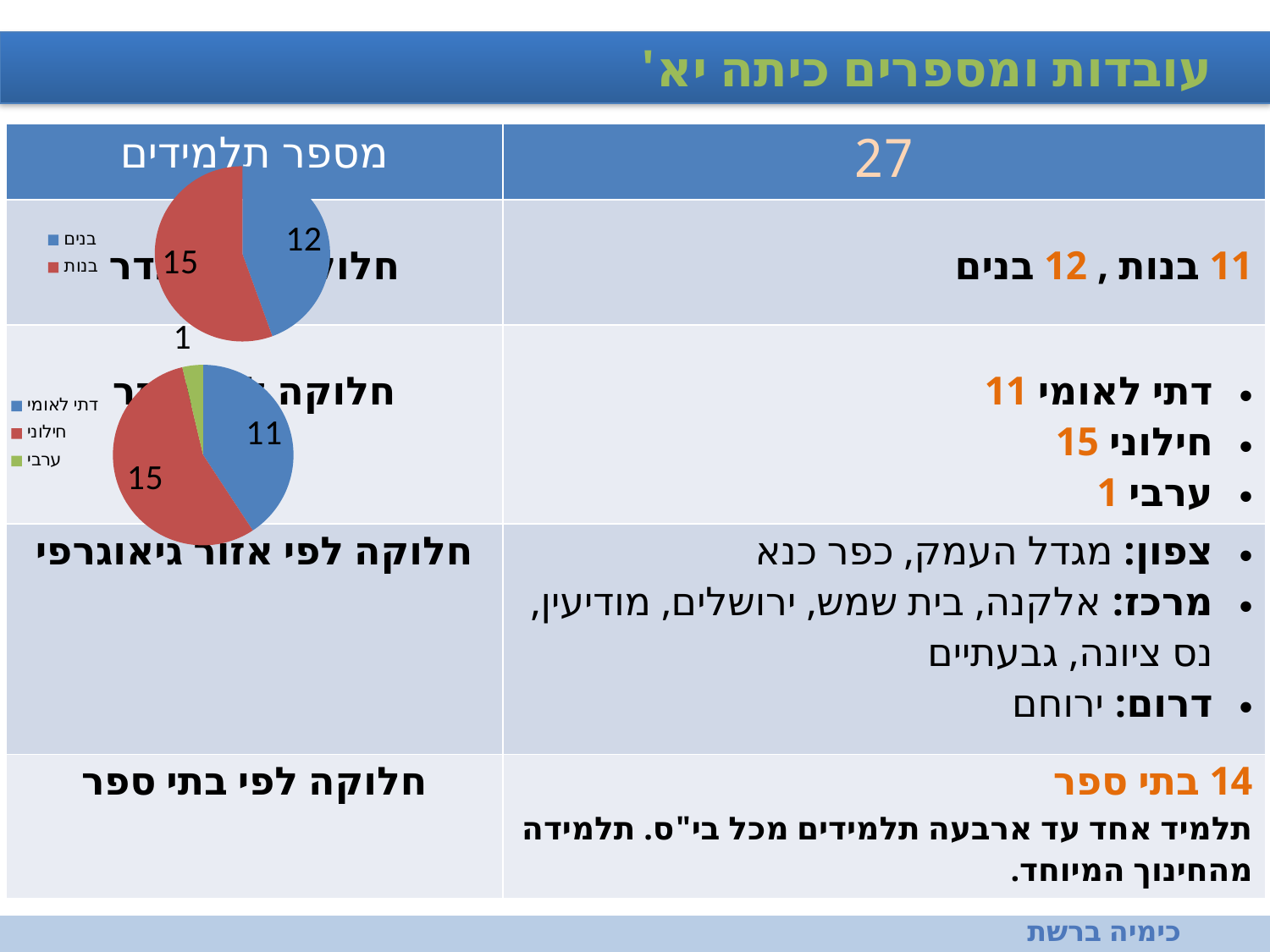
In the lower pie chart, which category has the smallest slice? ערבי In the lower pie chart, what is the value for ערבי? 1 What kind of chart is the upper chart on the slide? pie chart In the lower pie chart, what is the value for דתי לאומי? 11 In the upper pie chart, what is the value for בנים? 12 In the lower pie chart, what is the difference between the values for חילוני and דתי לאומי? 4 How many entries does the legend of the upper pie chart list? 2 How many categories does the lower pie chart show? 3 In the lower pie chart, what is the value for חילוני? 15 In the upper pie chart, what is the value for בנות? 15 What kind of chart is the lower chart on the slide? pie chart In the lower pie chart, which category has the largest slice? חילוני